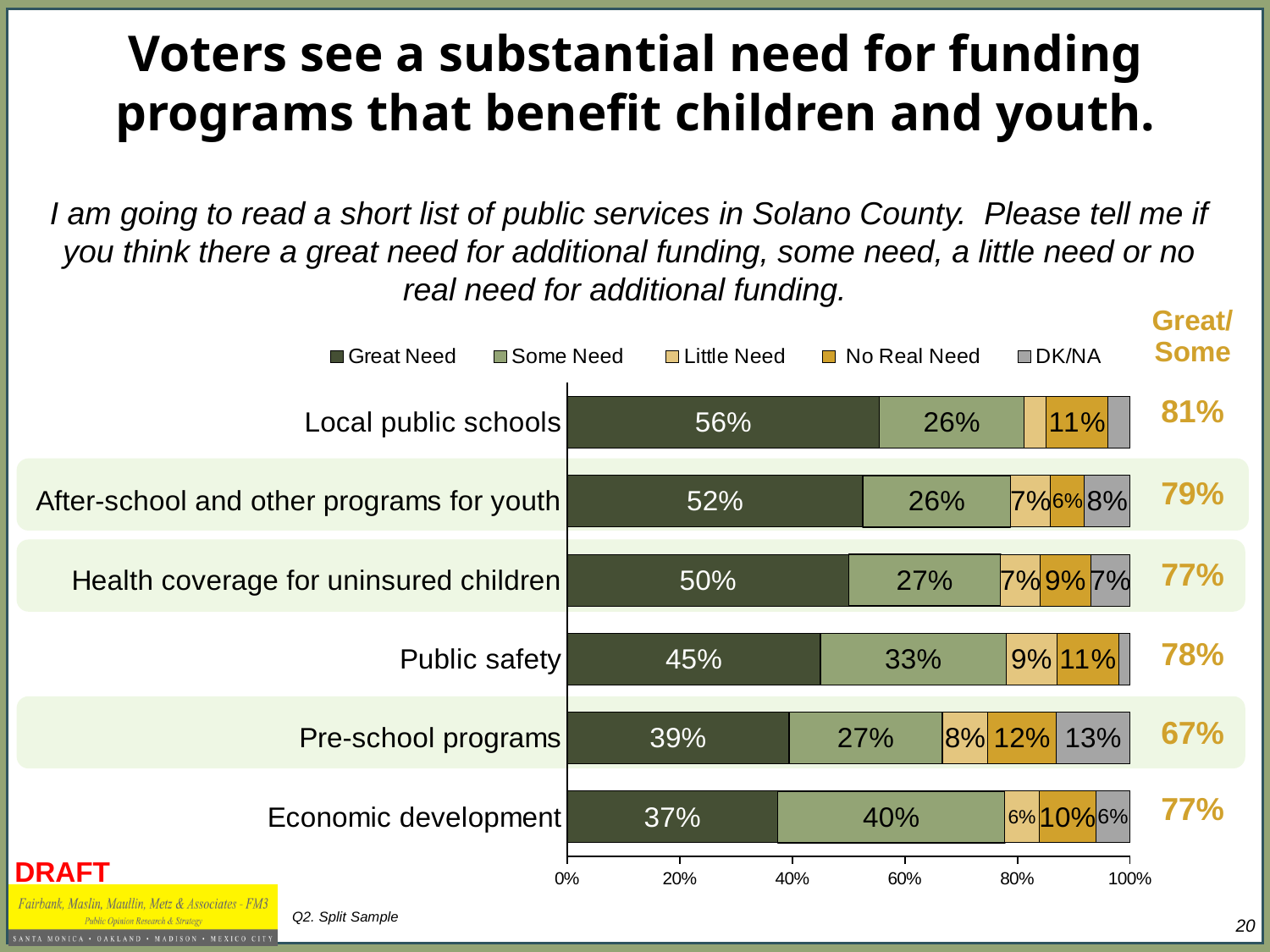
What percentage of voters said there is a Great Need for additional funding for Local public schools? 56% What type of chart is shown on the slide? Stacked bar chart How many percentage points higher is the Great Need value for Local public schools than for Pre-school programs? 17 percentage points What is the total of all labeled segments in the Health coverage for uninsured children bar? 100% How many response categories does the legend list? 5 Which has a larger Some Need value: Public safety or Health coverage for uninsured children? Public safety What is the Some Need value for Economic development? 40% Which category has the lowest Great Need value? Economic development How many public services are listed in the chart? 6 What is the DK/NA value for Pre-school programs? 13% Which category has the highest Great Need value? Local public schools What is the Great/Some combined figure shown for After-school and other programs for youth? 79%